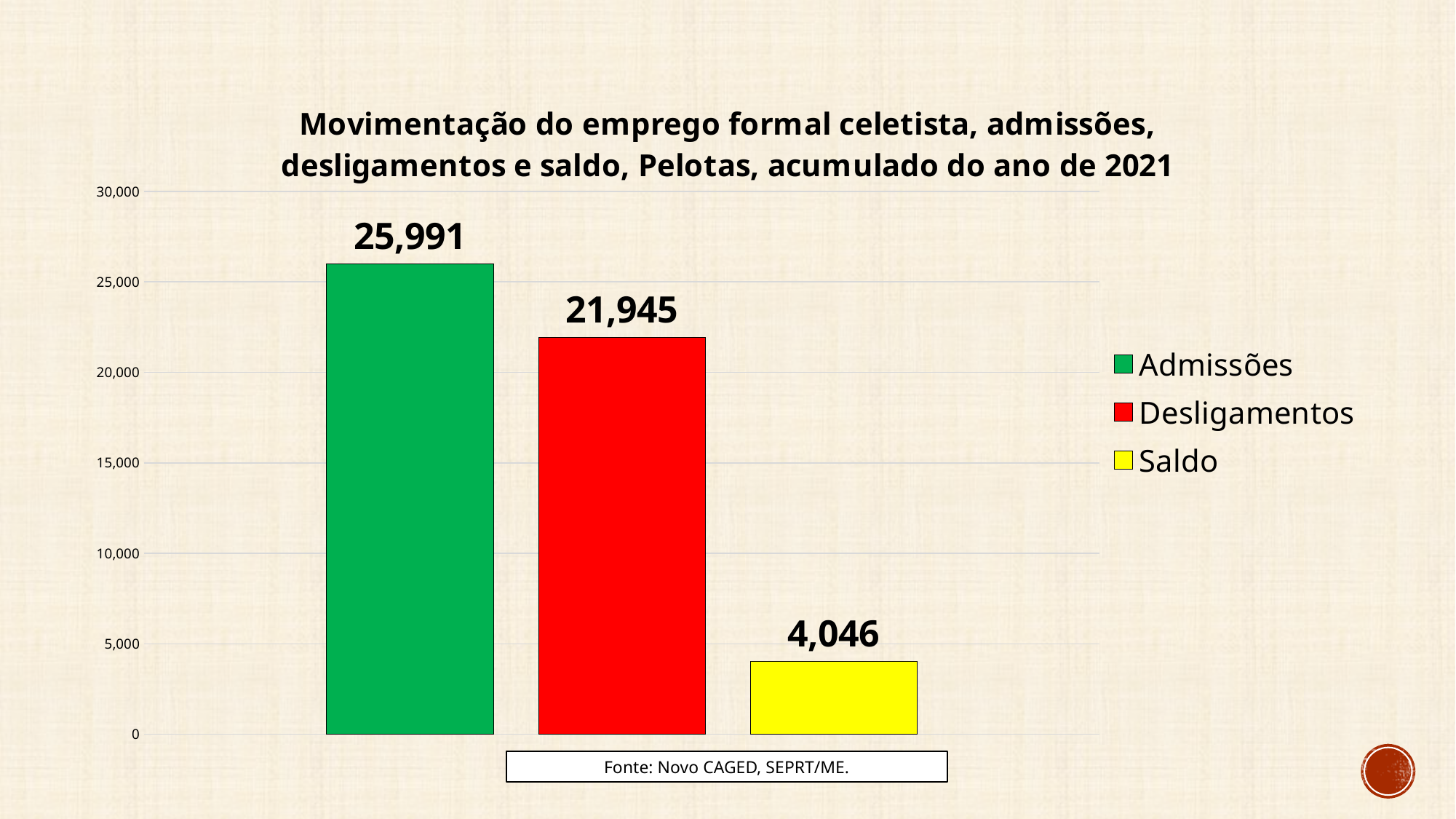
What is the value for Saldo? 4,046 How many series does the legend list? 3 Which series has the highest value? Admissões Which is larger, Admissões or Desligamentos? Admissões What colour is the bar for Desligamentos? red What is the difference between Desligamentos and Saldo? 17,899 What is the value for Desligamentos? 21,945 What kind of chart is shown on the slide? bar chart Is the value for Saldo greater or less than 5,000? less What is the value for Admissões? 25,991 Which series has the lowest value? Saldo What is the difference between Admissões and Desligamentos? 4,046